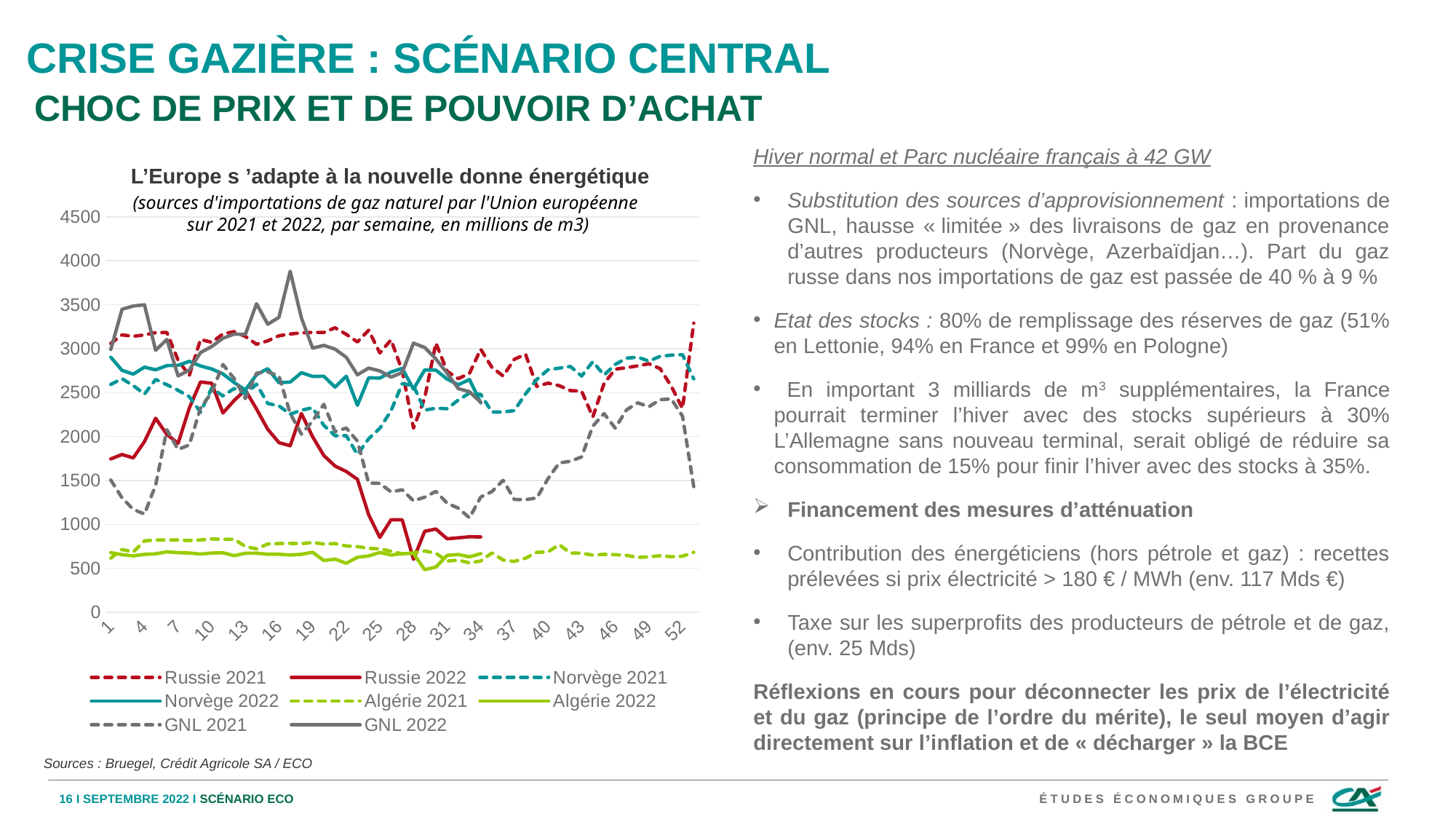
Is the value of Russie 2022 at week 34 greater or less than 1000? less What is the title of the chart? L'Europe s'adapte à la nouvelle donne énergétique How many series does the chart legend list? 8 What kind of chart is shown on the slide? Line chart Is the peak value of GNL 2022 (around week 18) greater or less than 3500? greater In what unit are the values on the chart expressed? Millions de m3 At week 1, which is larger: Russie 2021 or Russie 2022? Russie 2021 At week 34, which is larger: Norvège 2022 or Russie 2022? Norvège 2022 Is the value of Norvège 2022 at week 1 greater or less than 2500? greater Does the Russie 2022 series rise or fall between week 1 and week 34? Fall Which series reaches the highest point on the chart? GNL 2022